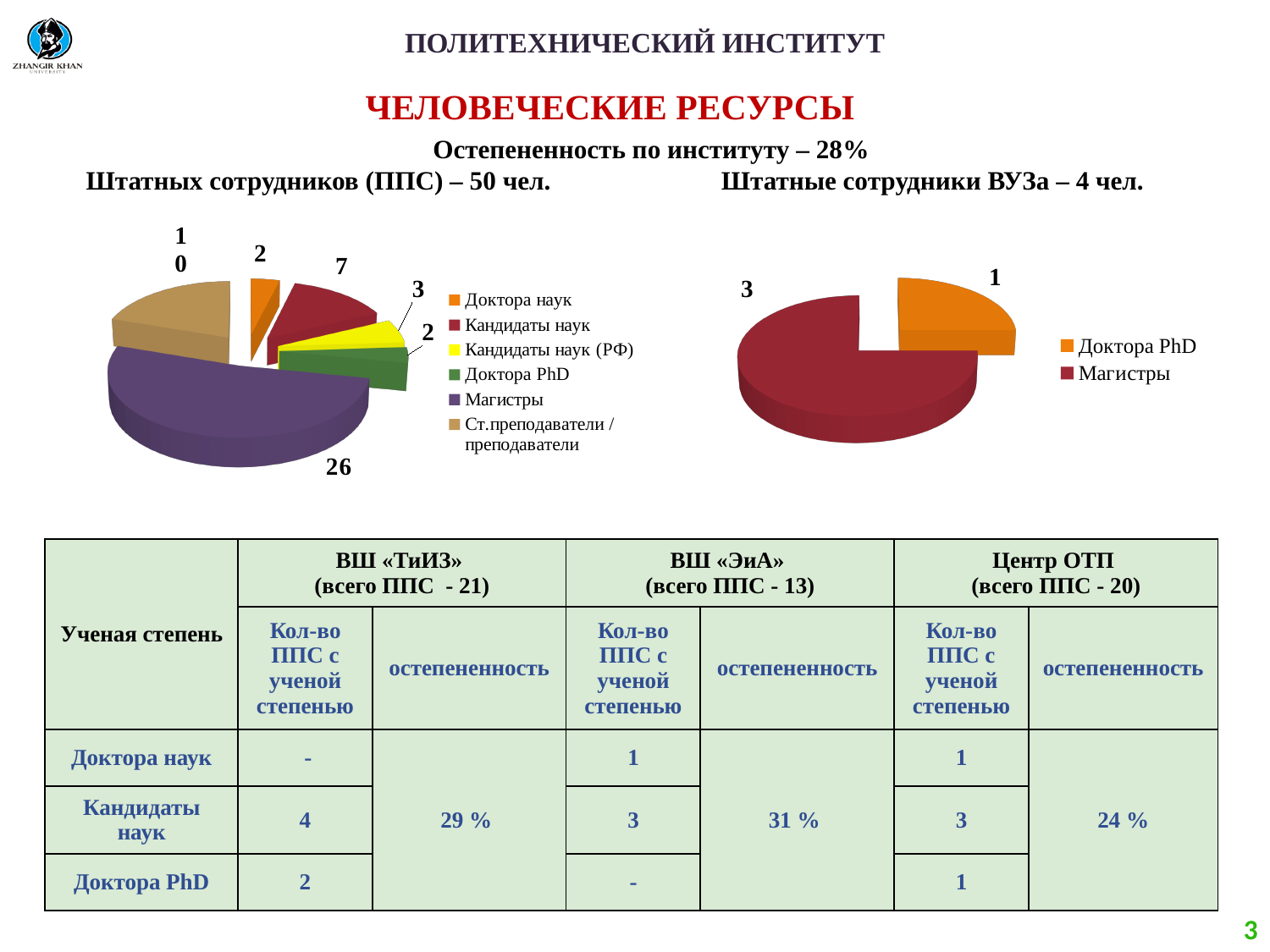
In the left pie chart (Штатных сотрудников (ППС) – 50 чел.), what is the difference between Магистры and Кандидаты наук? 19 In the left pie chart (Штатных сотрудников (ППС) – 50 чел.), what is the value for Кандидаты наук (РФ)? 3 In the left pie chart (Штатных сотрудников (ППС) – 50 чел.), how many categories does the legend list? 6 In the right pie chart (Штатные сотрудники ВУЗа – 4 чел.), what is the value for Магистры? 3 What type of chart is used on the left side of the slide (Штатных сотрудников (ППС) – 50 чел.)? Pie chart In the left pie chart (Штатных сотрудников (ППС) – 50 чел.), what is the value for Кандидаты наук? 7 In the left pie chart (Штатных сотрудников (ППС) – 50 чел.), which is larger: Кандидаты наук or Доктора наук? Кандидаты наук In the right pie chart (Штатные сотрудники ВУЗа – 4 чел.), what share of the total does Магистры represent? 75% In the left pie chart (Штатных сотрудников (ППС) – 50 чел.), what is the value for Магистры? 26 In the right pie chart (Штатные сотрудники ВУЗа – 4 чел.), what is the value for Доктора PhD? 1 In the right pie chart (Штатные сотрудники ВУЗа – 4 чел.), what colour is the Доктора PhD slice? Orange In the left pie chart (Штатных сотрудников (ППС) – 50 чел.), which category has the largest slice? Магистры